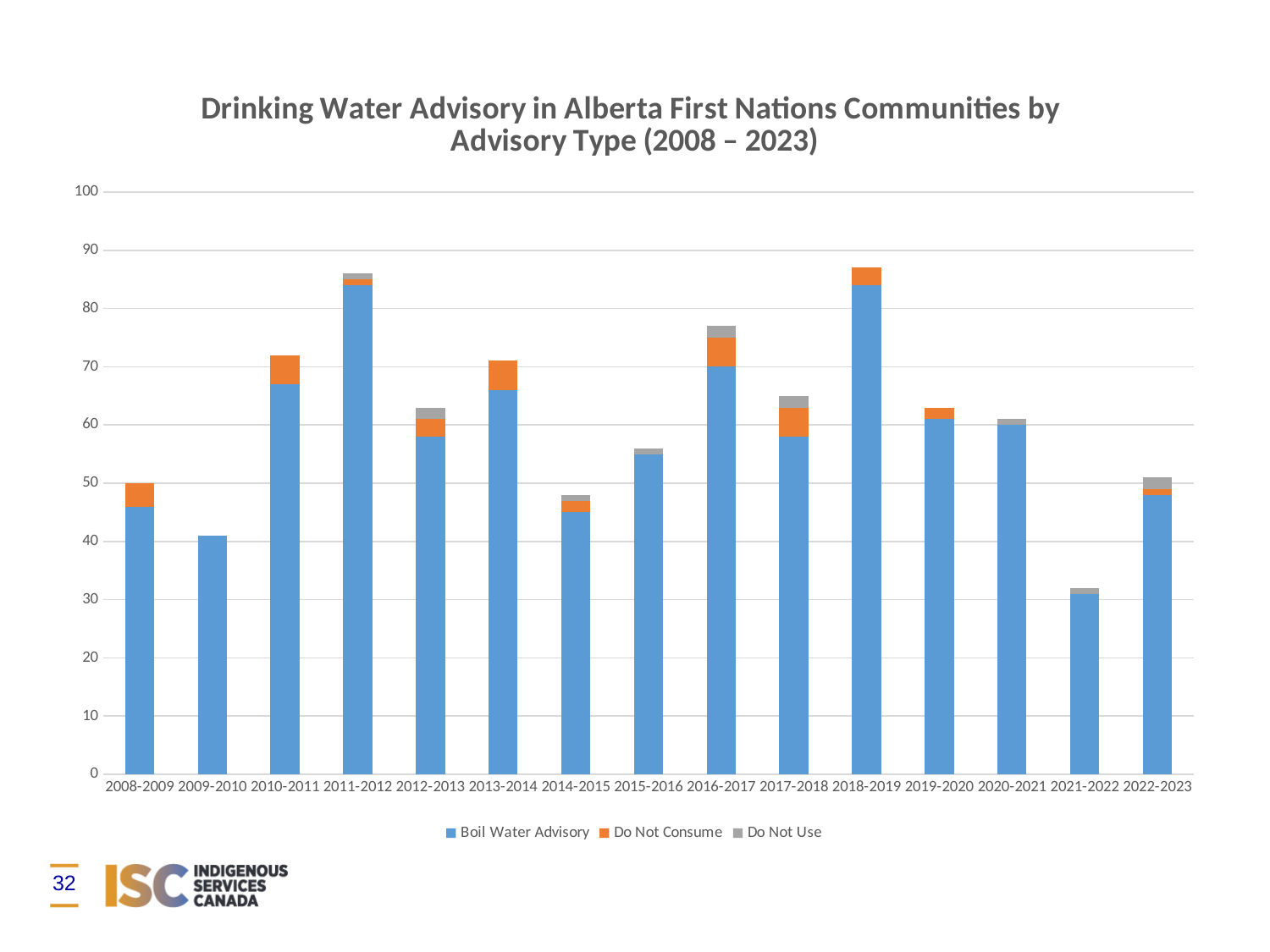
How many series does the legend list? 3 Which fiscal year has the lowest total number of drinking water advisories? 2021-2022 How many fiscal-year categories are shown on the x axis? 15 Which colour represents the Do Not Consume series in the legend? Orange Do the totals rise or fall from 2018-2019 to 2021-2022? fall Is the total for 2009-2010 greater or less than 50? less Which has the larger total, 2016-2017 or 2017-2018? 2016-2017 What kind of chart is shown on the slide? Stacked bar chart Is the total for 2016-2017 greater or less than 70? greater Is the total for 2021-2022 greater or less than 40? less Which has the larger total, 2008-2009 or 2009-2010? 2008-2009